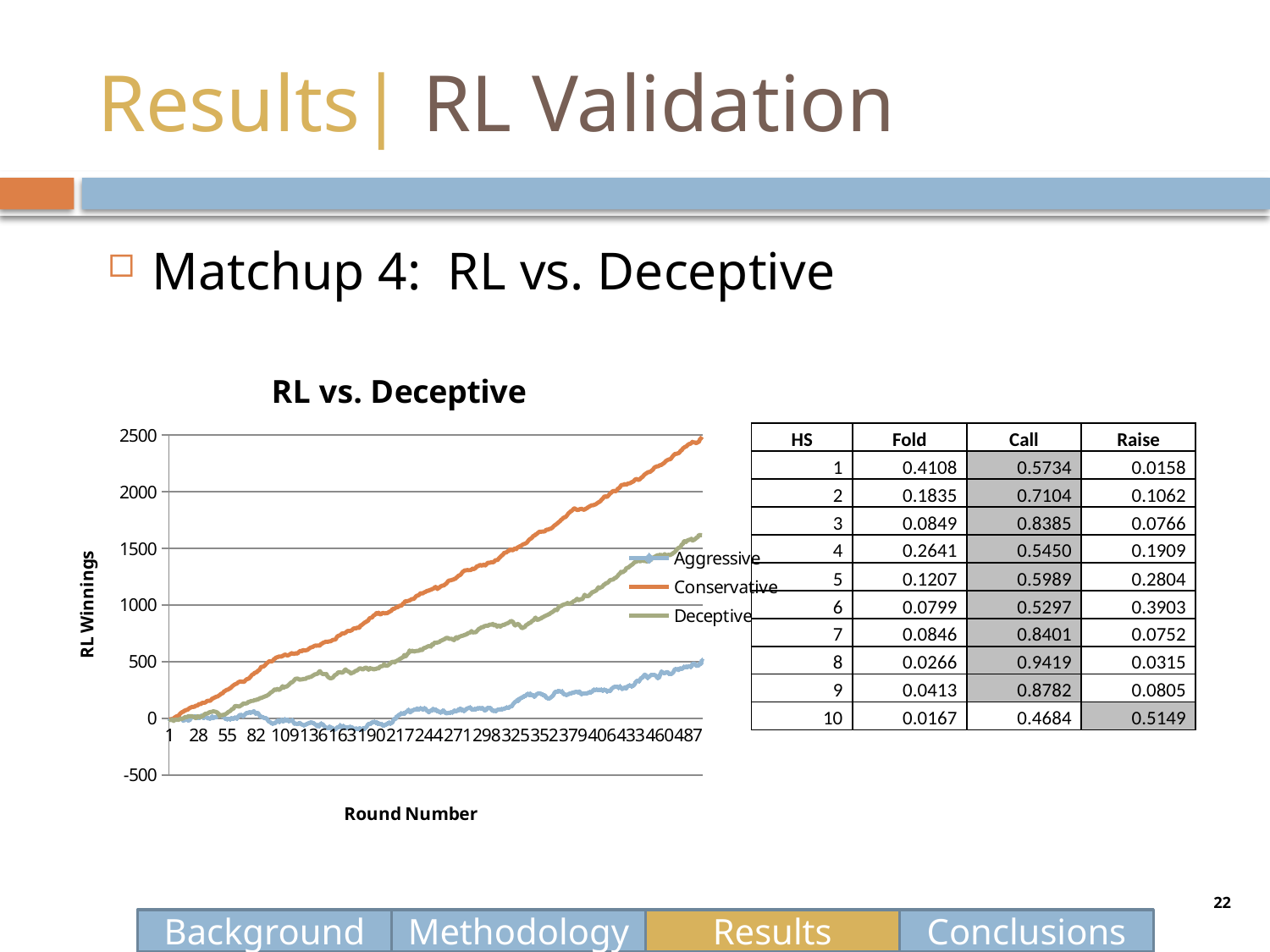
At the final round shown, which series has the larger value, Conservative or Deceptive? Conservative How many series does the legend of the chart list? 3 At the final round shown, which series has the larger value, Deceptive or Aggressive? Deceptive Do the values of the Conservative series rise or fall as the round number increases? rise Is the value for the Conservative series at the final round greater or less than 2000? greater Which series has the lowest RL Winnings at the final round shown? Aggressive Is the value for the Aggressive series at the final round greater or less than 1000? less Is the value for the Deceptive series at the final round greater or less than 1000? greater What is the label of the vertical axis of the chart? RL Winnings What is the title of the chart? RL vs. Deceptive Which series has the highest RL Winnings at the final round shown? Conservative What kind of chart is shown on the slide? line chart